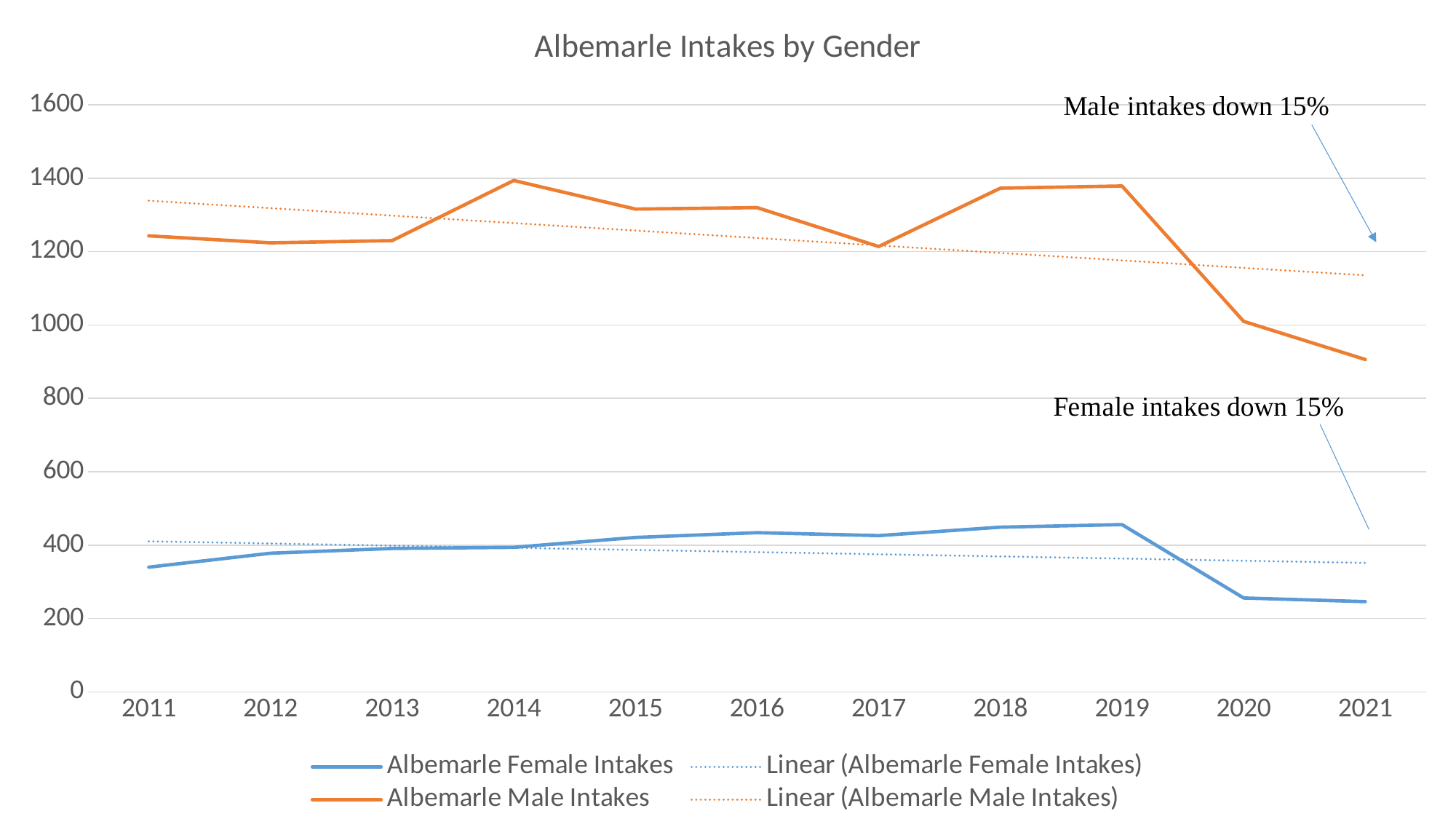
How many years are shown on the x axis? 11 According to the annotation on the chart, by what percentage are male intakes down? 15% Is the value for Albemarle Female Intakes in 2020 greater or less than 400? less What kind of chart is shown on the slide? line chart In which year are Albemarle Male Intakes lowest? 2021 Is the value for Albemarle Male Intakes in 2014 greater or less than 1200? greater Is the value for Albemarle Female Intakes in 2019 greater or less than 400? greater How many entries does the legend list? 4 What is the title of the chart? Albemarle Intakes by Gender Do Albemarle Male Intakes rise or fall from 2019 to 2021? fall Which is larger: Albemarle Male Intakes in 2014 or in 2011? 2014